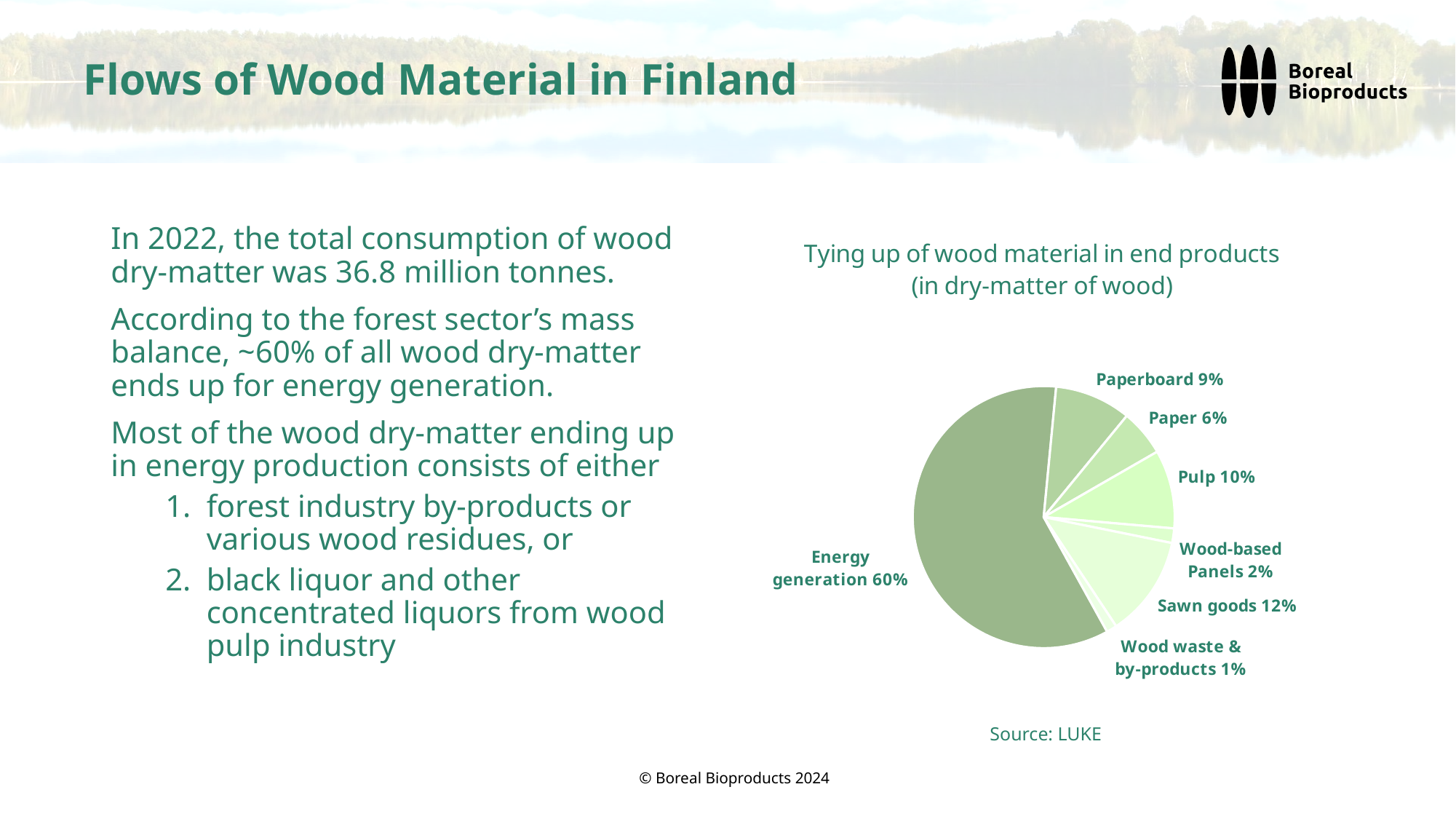
What is the title of the chart? Tying up of wood material in end products (in dry-matter of wood) What is the difference between the shares of Paperboard and Paper? 3% What kind of chart is shown on the slide? Pie chart What is the source cited for the chart? LUKE What share of the pie does Energy generation account for? 60% Which category has the smallest slice of the pie? Wood waste & by-products What is the value shown for Wood-based Panels? 2% Which category has the largest slice of the pie? Energy generation What is the value shown for Sawn goods? 12% Which is larger, the share for Sawn goods or the share for Pulp? Sawn goods What is the value shown for Pulp? 10% How many categories are shown in the pie chart? 7